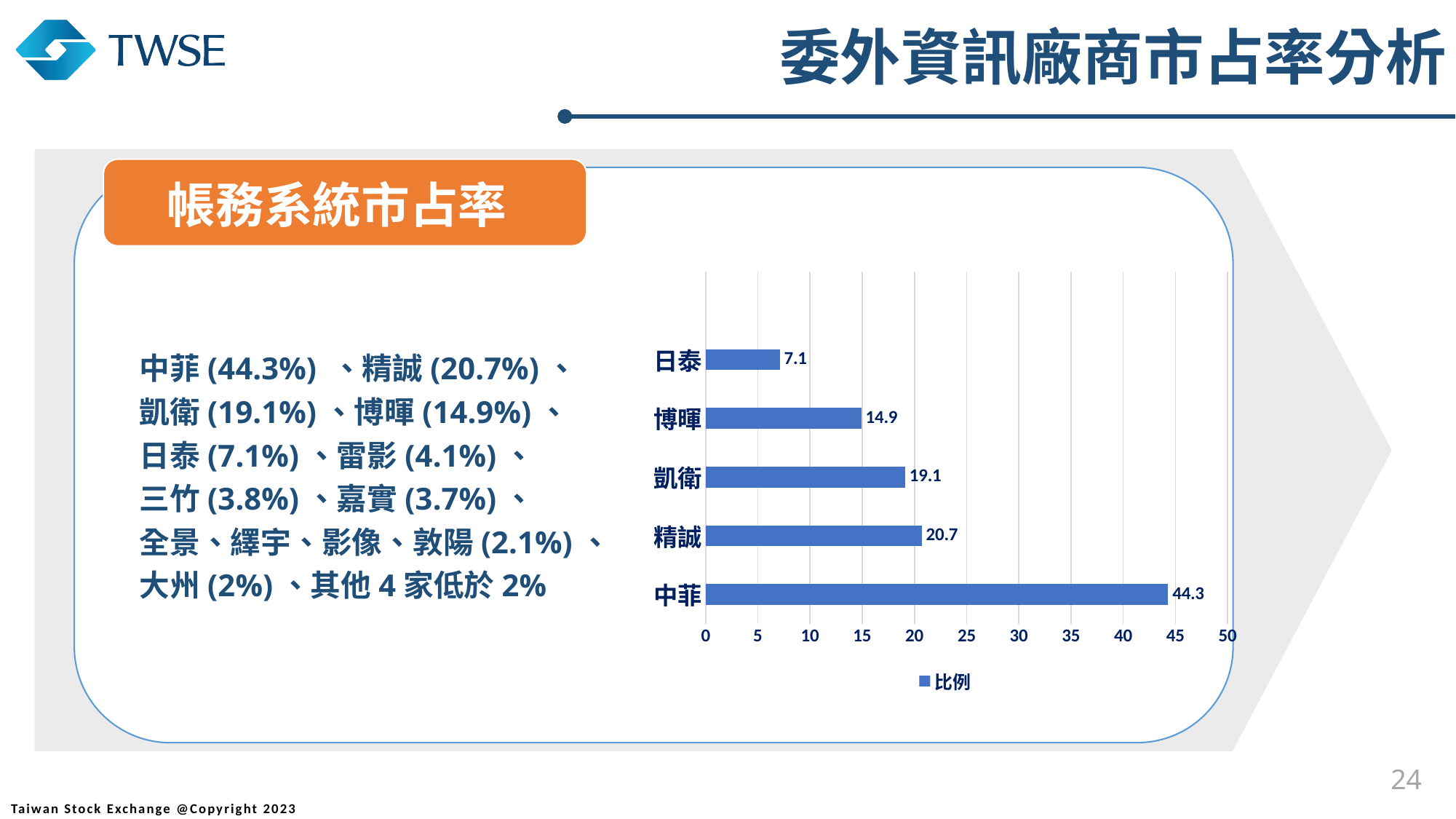
How many categories are shown in the bar chart? 5 What is the difference between the values for 凱衛 and 博暉? 4.2 What is the value for 日泰 in the bar chart? 7.1 What series name does the legend of the chart show? 比例 What is the difference between the values for 中菲 and 精誠? 23.6 Which category has the lowest value in the bar chart? 日泰 What is the value for 精誠 in the bar chart? 20.7 What kind of chart is shown on the slide? bar chart Is the value for 中菲 greater or less than 40? greater Which has a larger value, 凱衛 or 博暉? 凱衛 Which category has the highest value in the bar chart? 中菲 What is the value for 中菲 in the bar chart? 44.3